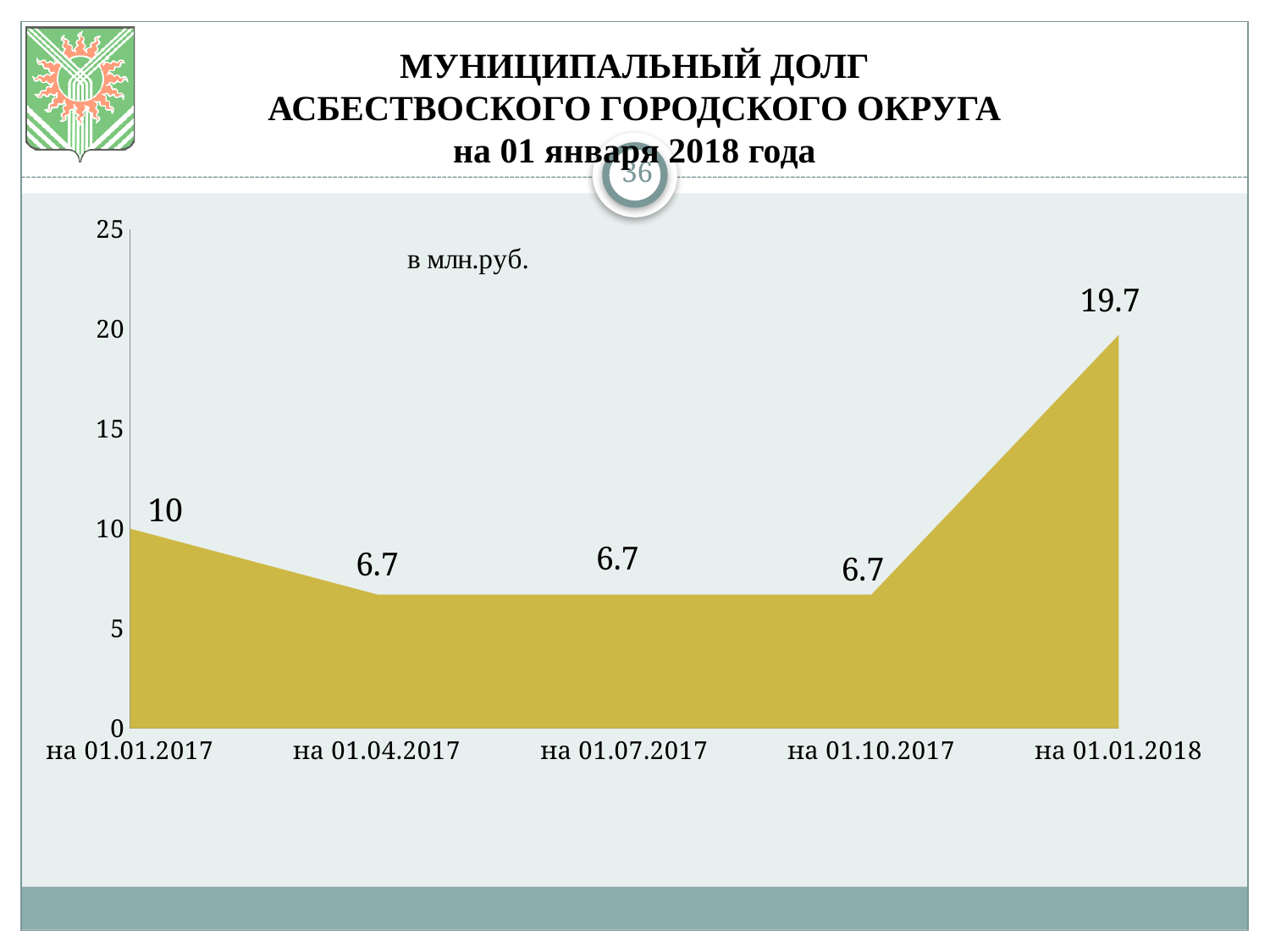
How many dates are plotted on the chart? 5 What is the municipal debt value on 01.07.2017? 6.7 What is the municipal debt value on 01.01.2017? 10 Is the debt on 01.01.2018 greater or less than 15? greater What kind of chart is shown on the slide? area chart What is the difference between the debt on 01.01.2017 and on 01.04.2017? 3.3 What is the difference between the debt on 01.01.2018 and on 01.10.2017? 13 Which is larger, the debt on 01.01.2017 or on 01.01.2018? на 01.01.2018 In what units are the values on the chart given? в млн.руб. On which date is the municipal debt highest? на 01.01.2018 Does the debt rise or fall between 01.10.2017 and 01.01.2018? rise What is the municipal debt value on 01.01.2018? 19.7